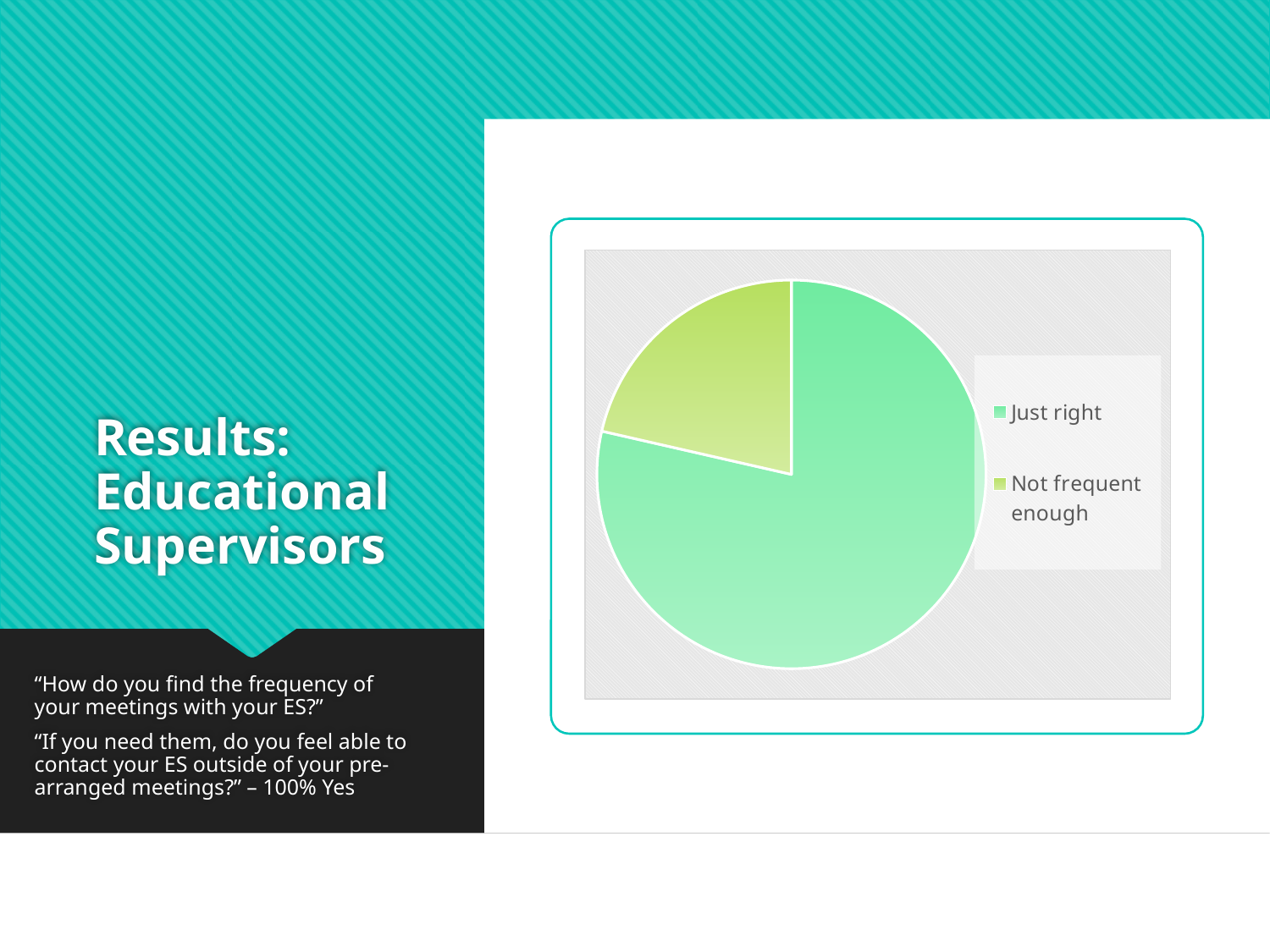
Which legend entry is shown in the yellow-green colour in the pie chart? Not frequent enough What are the two categories listed in the legend of the pie chart? Just right; Not frequent enough Which category has the smallest slice of the pie chart? Not frequent enough How many entries does the legend of the pie chart list? 2 Which category has the largest slice of the pie chart? Just right Does the "Just right" slice take up more or less than half of the pie chart? More How many slices does the pie chart have? 2 Which slice is larger in the pie chart, "Just right" or "Not frequent enough"? Just right What kind of chart is shown on the slide? Pie chart